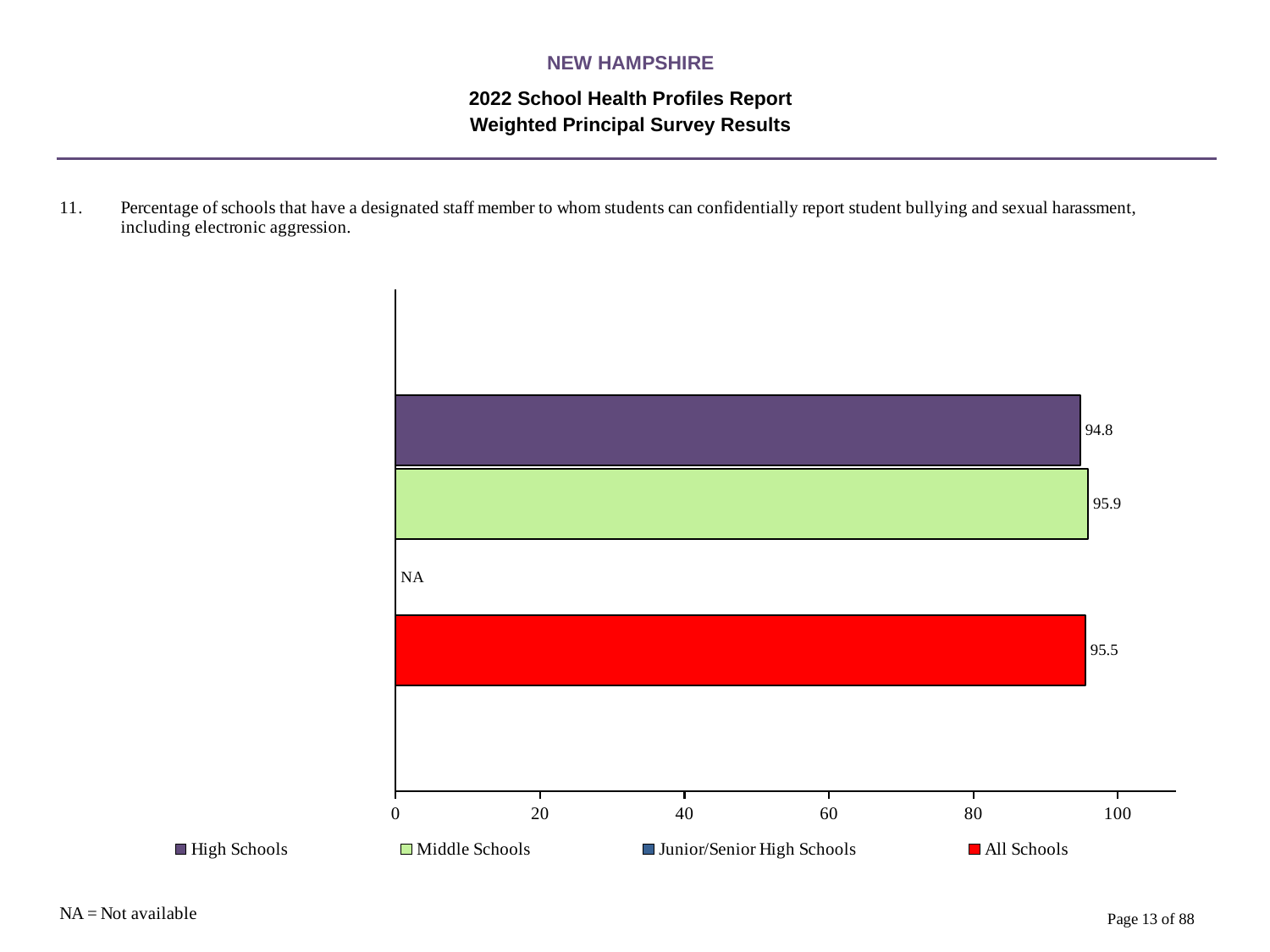
What is shown for Junior/Senior High Schools? NA Which school type has the lowest value among those with a plotted bar? High Schools What is the difference between the Middle Schools value and the High Schools value? 1.1 Is the value for High Schools greater or less than 80? greater What is the value for High Schools? 94.8 What colour is the All Schools bar? red Which school type has the highest value among those with a plotted bar? Middle Schools How many series does the legend list? 4 What is the difference between the All Schools value and the High Schools value? 0.7 What is the value for All Schools? 95.5 What kind of chart is shown on the slide? bar chart What is the value for Middle Schools? 95.9